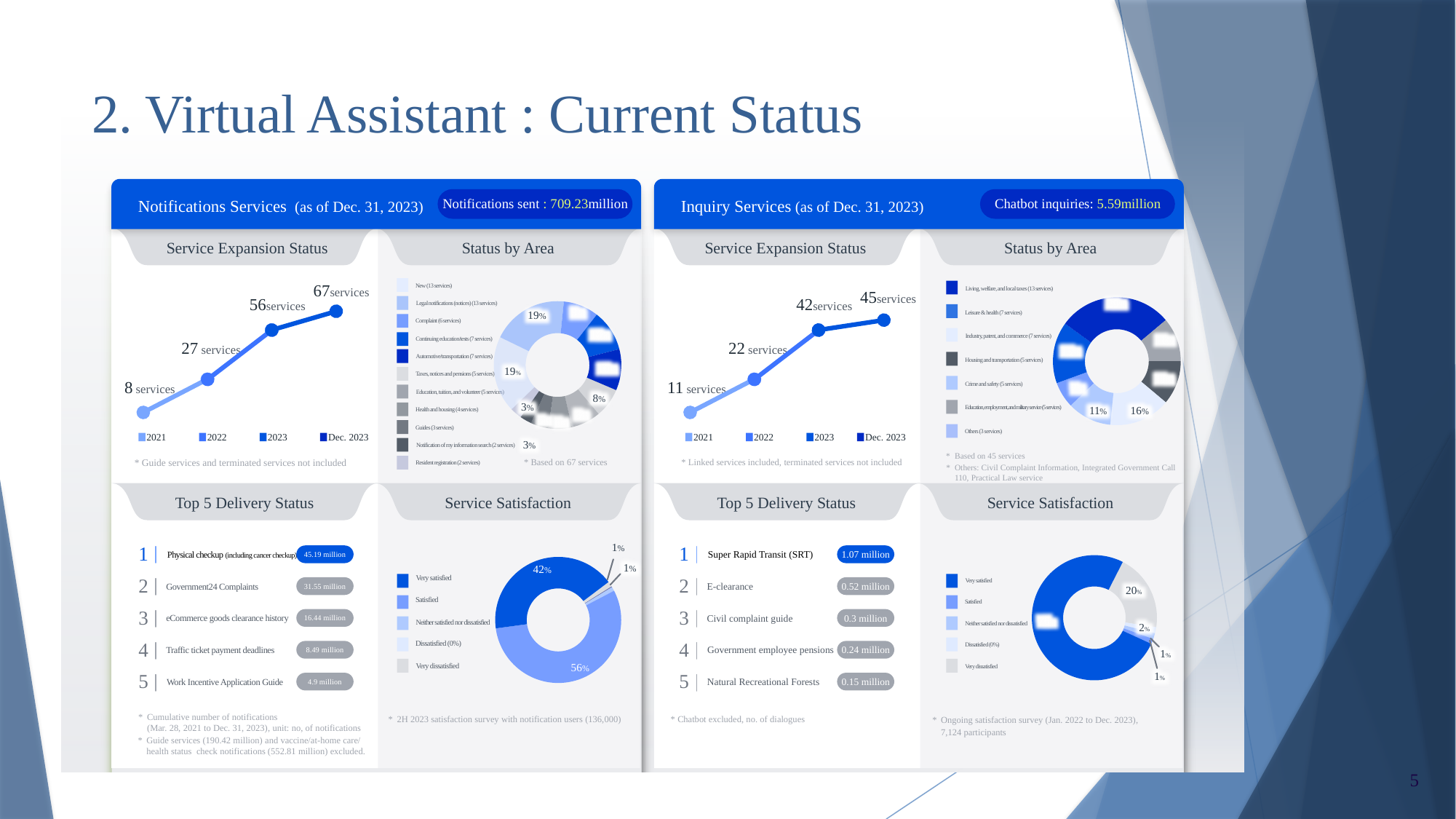
In the Inquiry Services 'Service Expansion Status' chart, what is the difference between the 2023 and 2022 values? 20 services In the Notifications Services 'Service Expansion Status' chart, how many services are shown for 2021? 8 services In the Inquiry Services 'Service Expansion Status' chart, how many services are shown for Dec. 2023? 45 services In the Notifications Services 'Service Expansion Status' chart, how many data points are plotted? 4 In the Notifications Services 'Service Expansion Status' chart, do the values rise or fall from 2021 to Dec. 2023? rise How many entries does the legend of the Inquiry Services 'Service Satisfaction' chart list? 5 In the Notifications Services 'Service Satisfaction' chart, what share is 'Satisfied'? 56% In the Notifications Services 'Service Satisfaction' chart, which is larger: 'Very satisfied' or 'Satisfied'? Satisfied What kind of chart is the Notifications Services 'Service Expansion Status' chart? line chart In the Notifications Services 'Service Expansion Status' chart, how many services are shown for 2023? 56 services In the Notifications Services 'Service Satisfaction' chart, what share is 'Very satisfied'? 42% In the Inquiry Services 'Service Expansion Status' chart, which period has the highest value? Dec. 2023